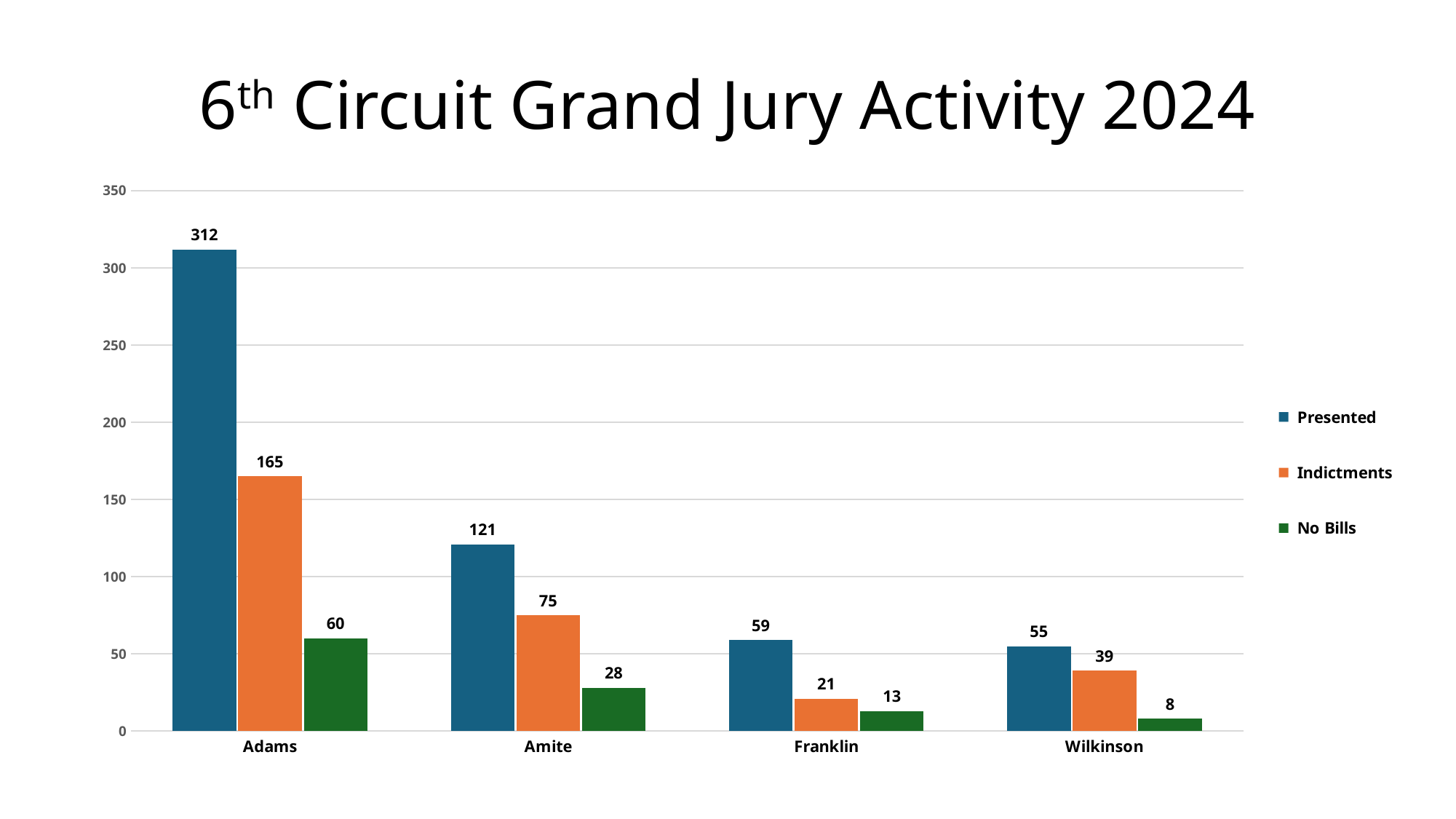
How many counties are shown on the x axis? 4 What is the No Bills value for Wilkinson? 8 Which is larger, the Presented value for Franklin or the Presented value for Wilkinson? Franklin How many series does the legend list? 3 Which county has the lowest number of Indictments? Franklin What is the title of the chart? 6th Circuit Grand Jury Activity 2024 Which county has the highest Presented value? Adams What kind of chart is shown on the slide? bar chart Is the Indictments value for Adams greater or less than 150? greater What is the number of Indictments for Amite? 75 How many cases were Presented in Adams? 312 What is the difference between Presented and Indictments for Adams? 147